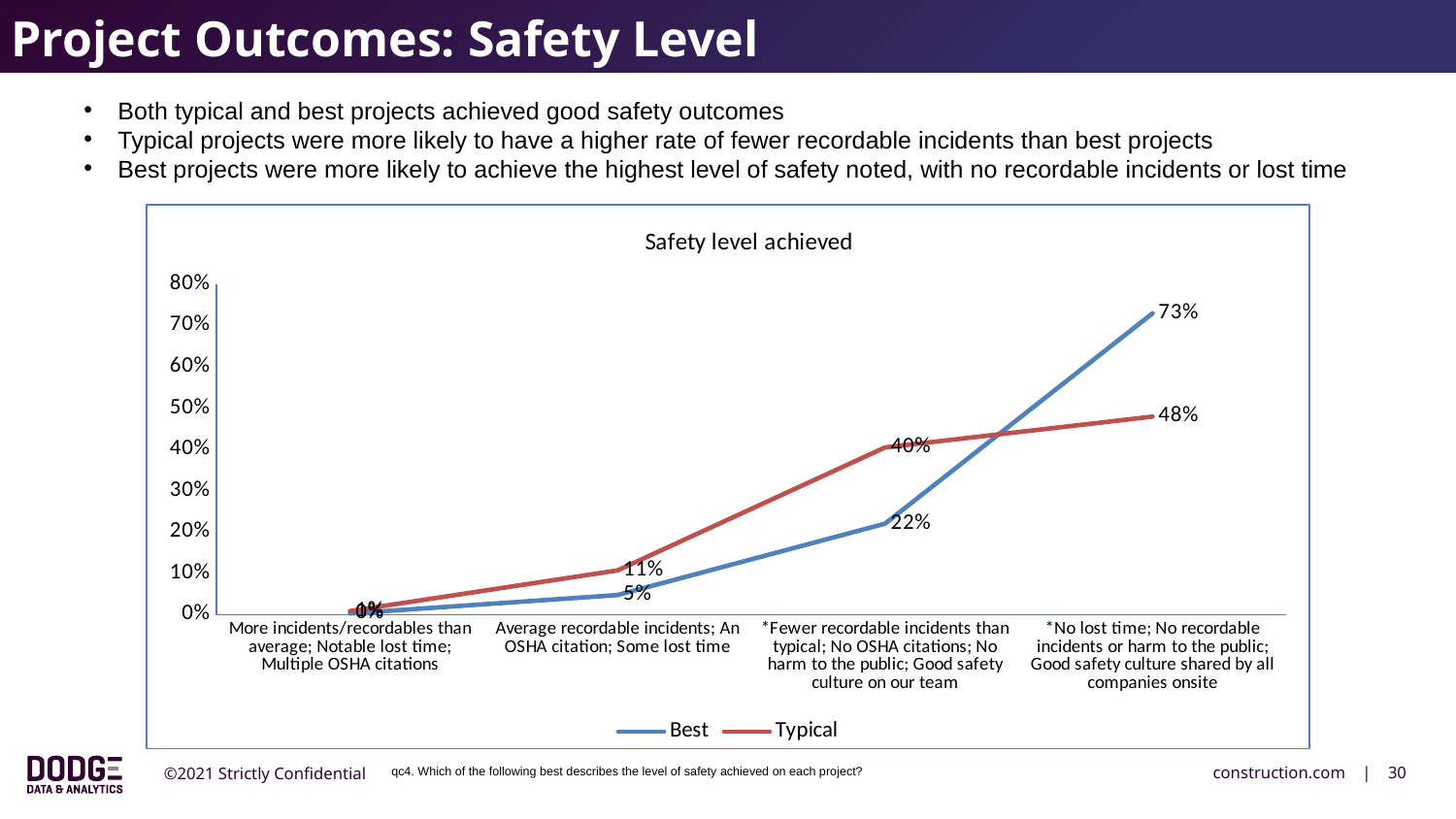
What is the title of the chart? Safety level achieved What type of chart is shown on the slide? line chart What is the value for Typical in the category "*Fewer recordable incidents than typical; No OSHA citations; No harm to the public; Good safety culture on our team"? 40% What is the value for Typical in the category "*No lost time; No recordable incidents or harm to the public; Good safety culture shared by all companies onsite"? 48% In the category "*Fewer recordable incidents than typical; No OSHA citations; No harm to the public; Good safety culture on our team", which series has the larger value, Best or Typical? Typical What is the difference between Best and Typical in the category "*No lost time; No recordable incidents or harm to the public; Good safety culture shared by all companies onsite"? 25% What is the value for Best in the category "Average recordable incidents; An OSHA citation; Some lost time"? 5% How many categories are shown on the x axis? 4 Which category has the highest value for the Best series? *No lost time; No recordable incidents or harm to the public; Good safety culture shared by all companies onsite How many series does the legend list? 2 Do the values for the Best series rise or fall from left to right along the x axis? rise What is the value for Best in the category "*No lost time; No recordable incidents or harm to the public; Good safety culture shared by all companies onsite"? 73%